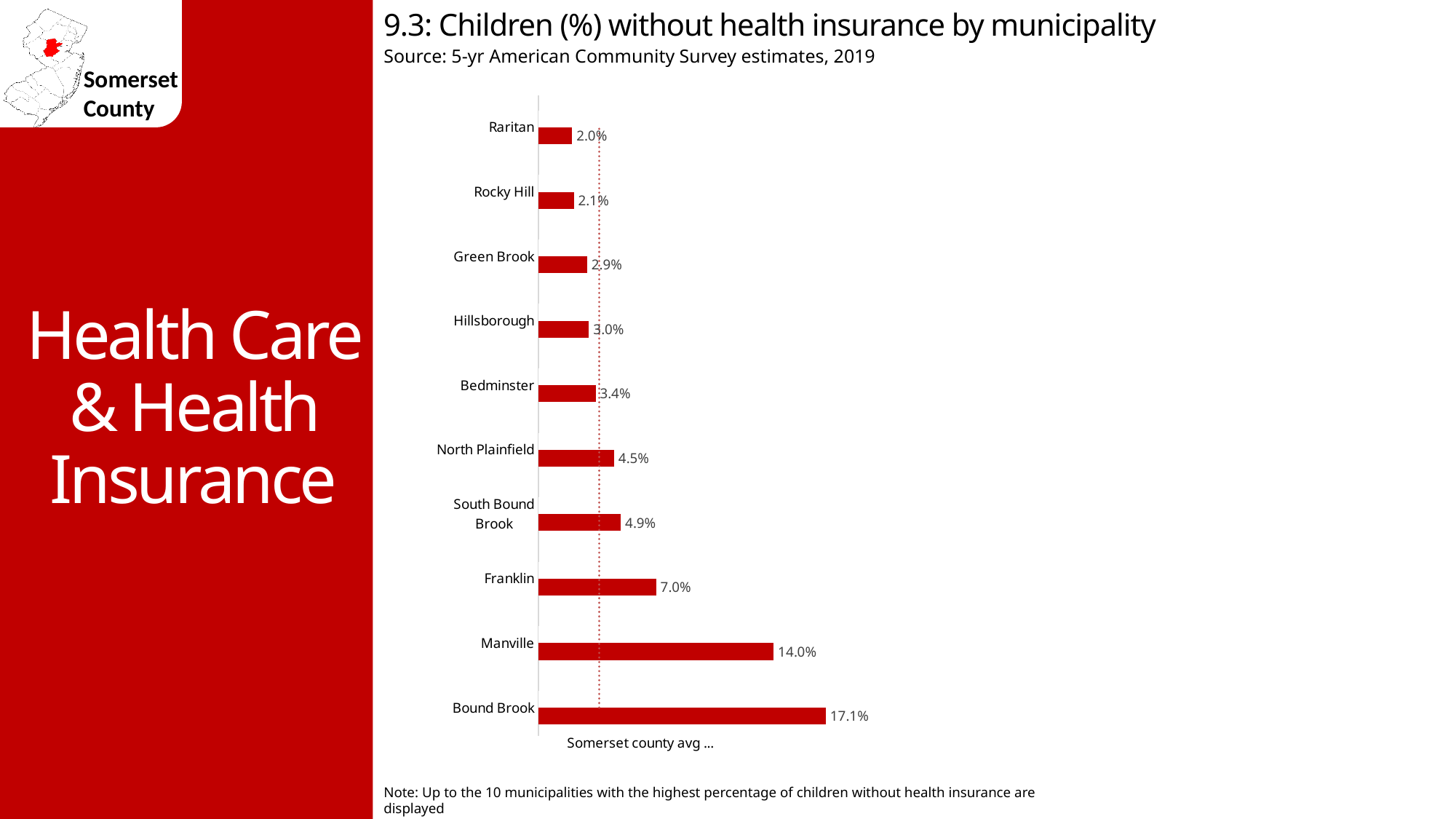
How many municipalities are shown in the chart? 10 Which municipality has the highest percentage of children without health insurance? Bound Brook What percentage of children in Bound Brook are without health insurance? 17.1% Which municipality has the lowest percentage of children without health insurance? Raritan What is the value for South Bound Brook? 4.9% What is the difference between the values for Bound Brook and Manville? 3.1% What kind of chart is shown on the slide? Bar chart What percentage is shown for Hillsborough? 3.0% What is the value shown for Manville? 14.0% What is the difference between the values for Franklin and North Plainfield? 2.5% Which has a higher value, Bedminster or Green Brook? Bedminster What does the dotted vertical line in the chart represent? Somerset county avg